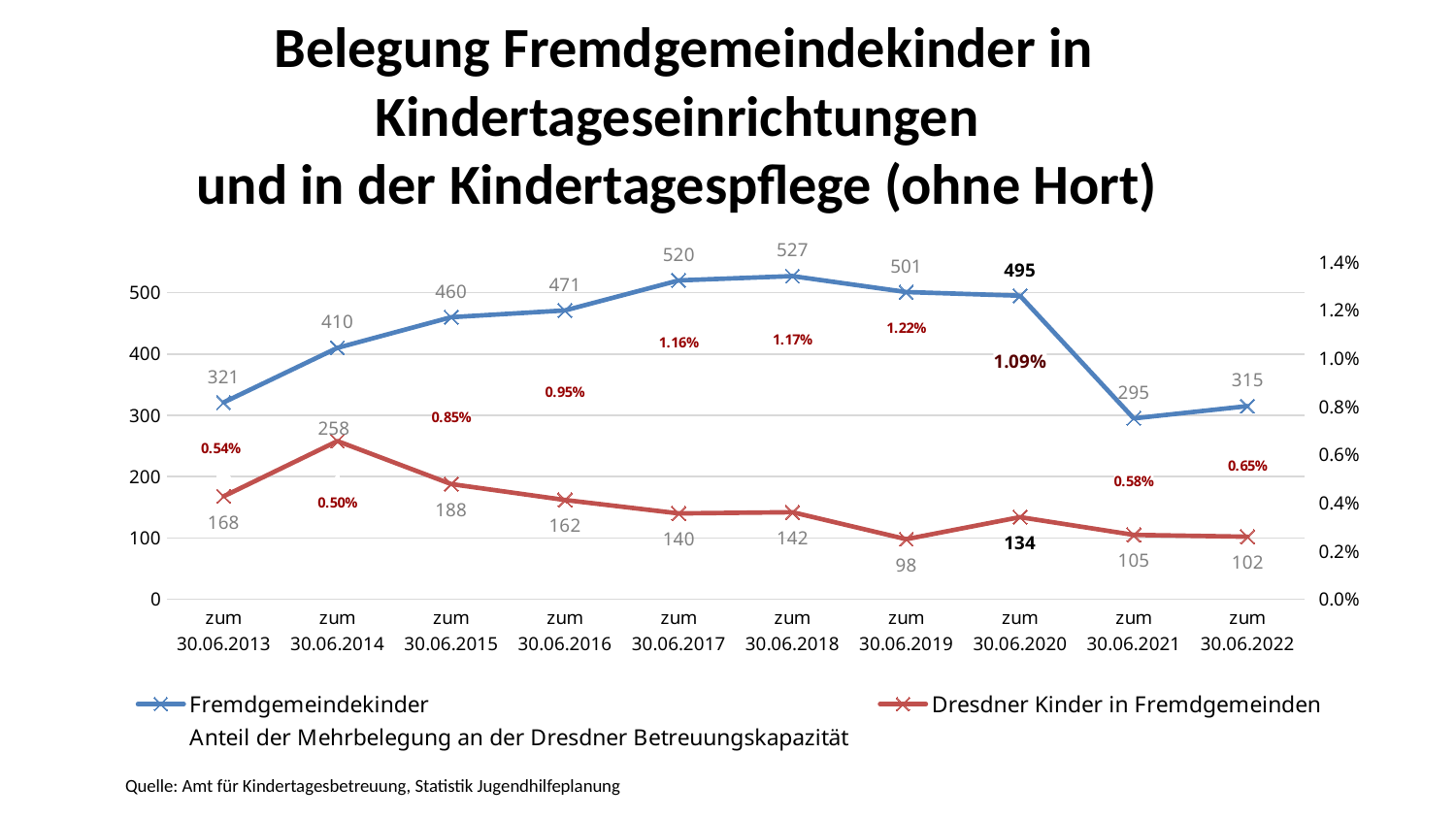
Which series is drawn in red? Dresdner Kinder in Fremdgemeinden What is the difference between the Fremdgemeindekinder values zum 30.06.2020 and zum 30.06.2021? 200 What percentage is shown for the Anteil der Mehrbelegung an der Dresdner Betreuungskapazität zum 30.06.2019? 1.22% What is the difference between the Dresdner Kinder in Fremdgemeinden values zum 30.06.2014 and zum 30.06.2015? 70 What is the value for Fremdgemeindekinder zum 30.06.2018? 527 What kind of chart is shown on the slide? line chart How many dates are shown on the x axis? 10 Zum 30.06.2013, which series has the larger value: Fremdgemeindekinder or Dresdner Kinder in Fremdgemeinden? Fremdgemeindekinder At which date does the Dresdner Kinder in Fremdgemeinden series reach its lowest value? zum 30.06.2019 Does the Fremdgemeindekinder series rise or fall from zum 30.06.2013 to zum 30.06.2018? rise What is the value for Dresdner Kinder in Fremdgemeinden zum 30.06.2014? 258 At which date does the Fremdgemeindekinder series reach its highest value? zum 30.06.2018